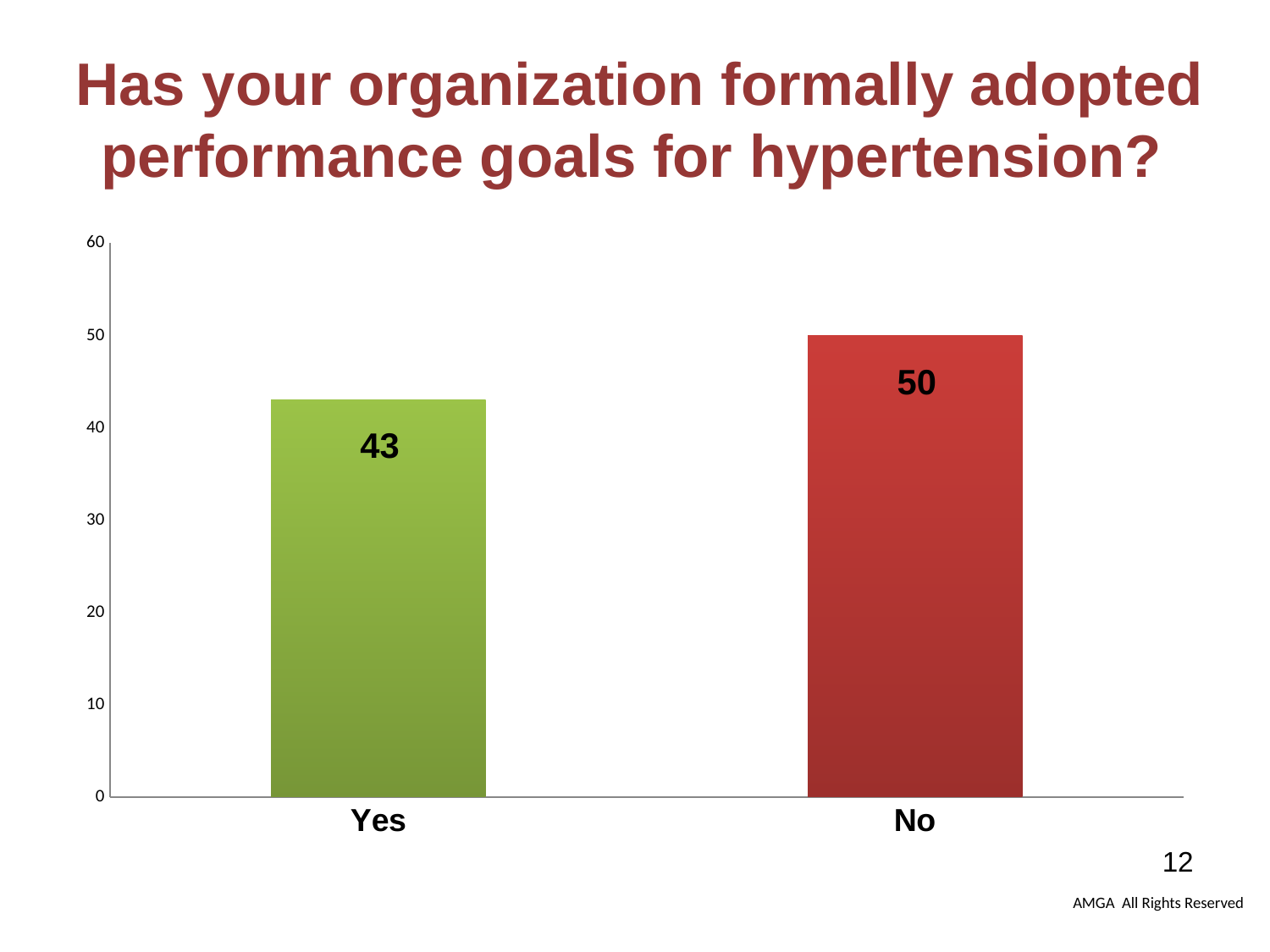
What colour is the bar for No? red Is the value for Yes greater or less than 40? greater What is the value for No? 50 How many categories are shown on the x axis? 2 What is the value for Yes? 43 What is the difference between the values for No and Yes? 7 Which category has the lowest value? Yes What kind of chart is shown on the slide? bar chart Which category has the highest value? No What is the maximum value shown on the vertical axis? 60 Which is larger, the value for Yes or the value for No? No